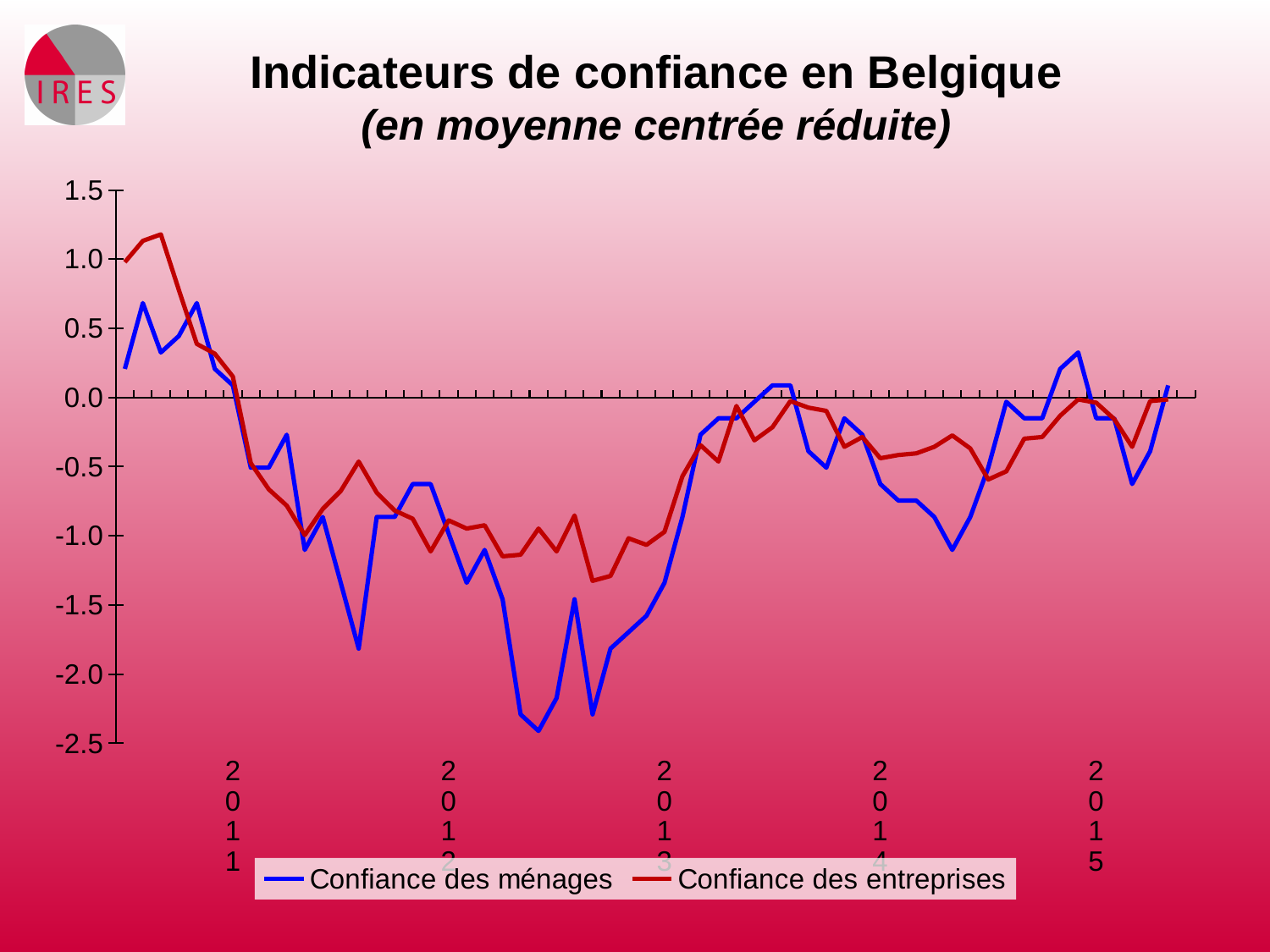
How many year labels are shown on the x axis? 5 What is the title of the chart? Indicateurs de confiance en Belgique (en moyenne centrée réduite) How many series does the legend list? 2 Do both series rise or fall between the start of the chart and the 2012 label? fall What kind of chart is shown on the slide? line chart Is the lowest value of Confiance des ménages greater or less than -2.0? less Which series is drawn in blue? Confiance des ménages Is the value of Confiance des ménages at the 2013 label greater or less than -1.0? less Is the highest value of Confiance des entreprises greater or less than 1.0? greater Which series reaches the highest value on the chart? Confiance des entreprises At the far left of the chart, which series has the higher value, Confiance des ménages or Confiance des entreprises? Confiance des entreprises Which series reaches the lowest value on the chart? Confiance des ménages